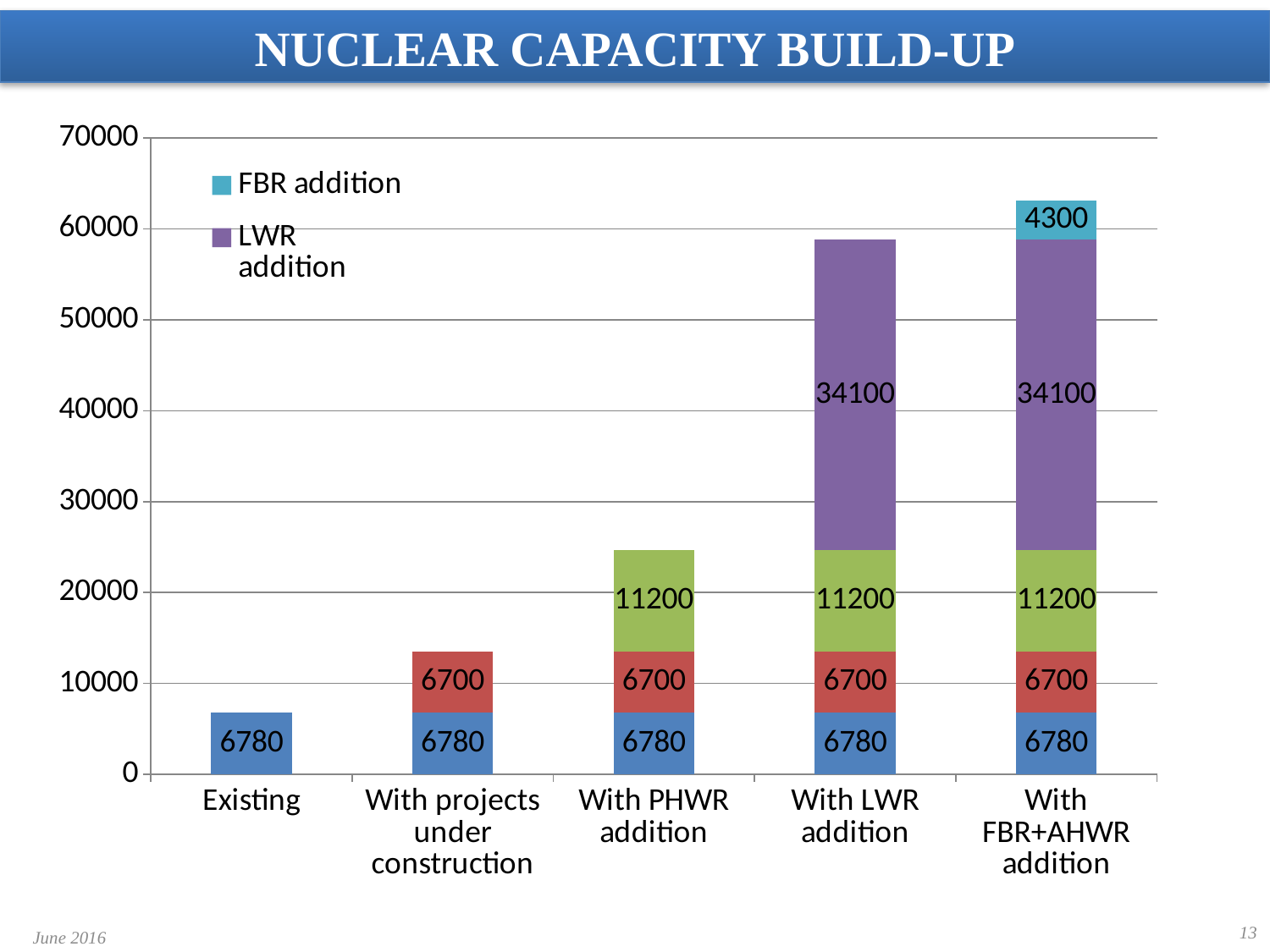
What is the total of the 'With projects under construction' stacked bar? 13480 What kind of chart is shown on the slide? Stacked bar chart Is the total of the 'With LWR addition' bar greater or less than 50000? greater What is the difference between the LWR addition segment (34100) and the FBR addition segment (4300) in the 'With FBR+AHWR addition' bar? 29800 What is the value labelled on the 'Existing' bar? 6780 How many series does the legend list? 2 What is the value of the FBR addition segment in the 'With FBR+AHWR addition' bar? 4300 How many categories are shown along the x axis? 5 Which category has the tallest stacked bar? With FBR+AHWR addition What is the value of the LWR addition segment in the 'With LWR addition' bar? 34100 What is the total of the 'With FBR+AHWR addition' stacked bar? 63080 Which category has the shortest bar? Existing